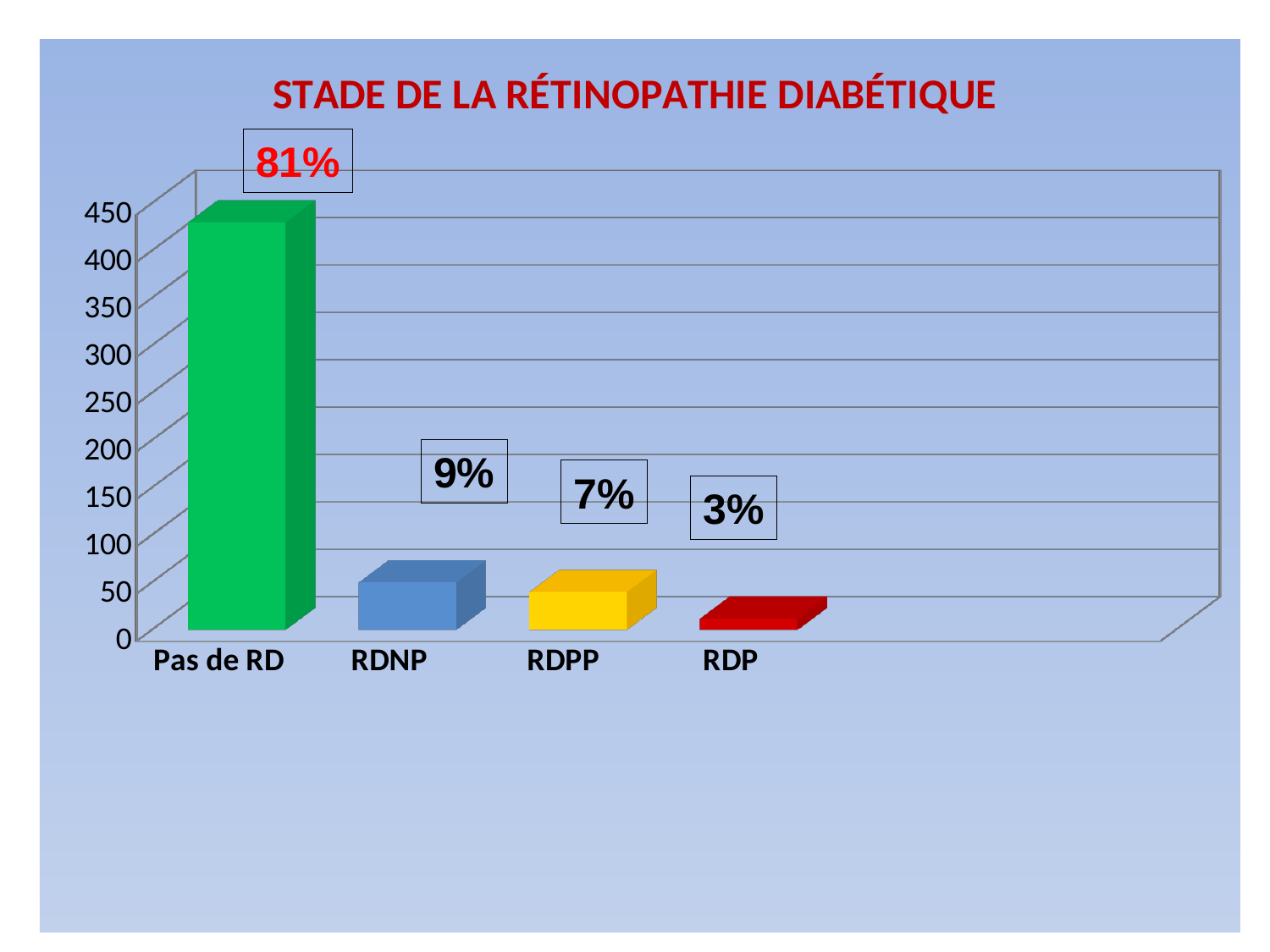
What kind of chart is shown on the slide? Bar chart Is the value for Pas de RD greater or less than 400? greater Which category has the highest bar? Pas de RD What is the title of the chart? STADE DE LA RÉTINOPATHIE DIABÉTIQUE What percentage label is shown for the RDP bar? 3% What percentage label is shown for the RDNP bar? 9% Which category has the lowest bar? RDP What percentage label is shown for the Pas de RD bar? 81% What percentage label is shown for the RDPP bar? 7% How many categories are shown on the x axis? 4 Is the value for RDNP greater or less than 100? less Which is larger, the value for RDNP or the value for RDPP? RDNP